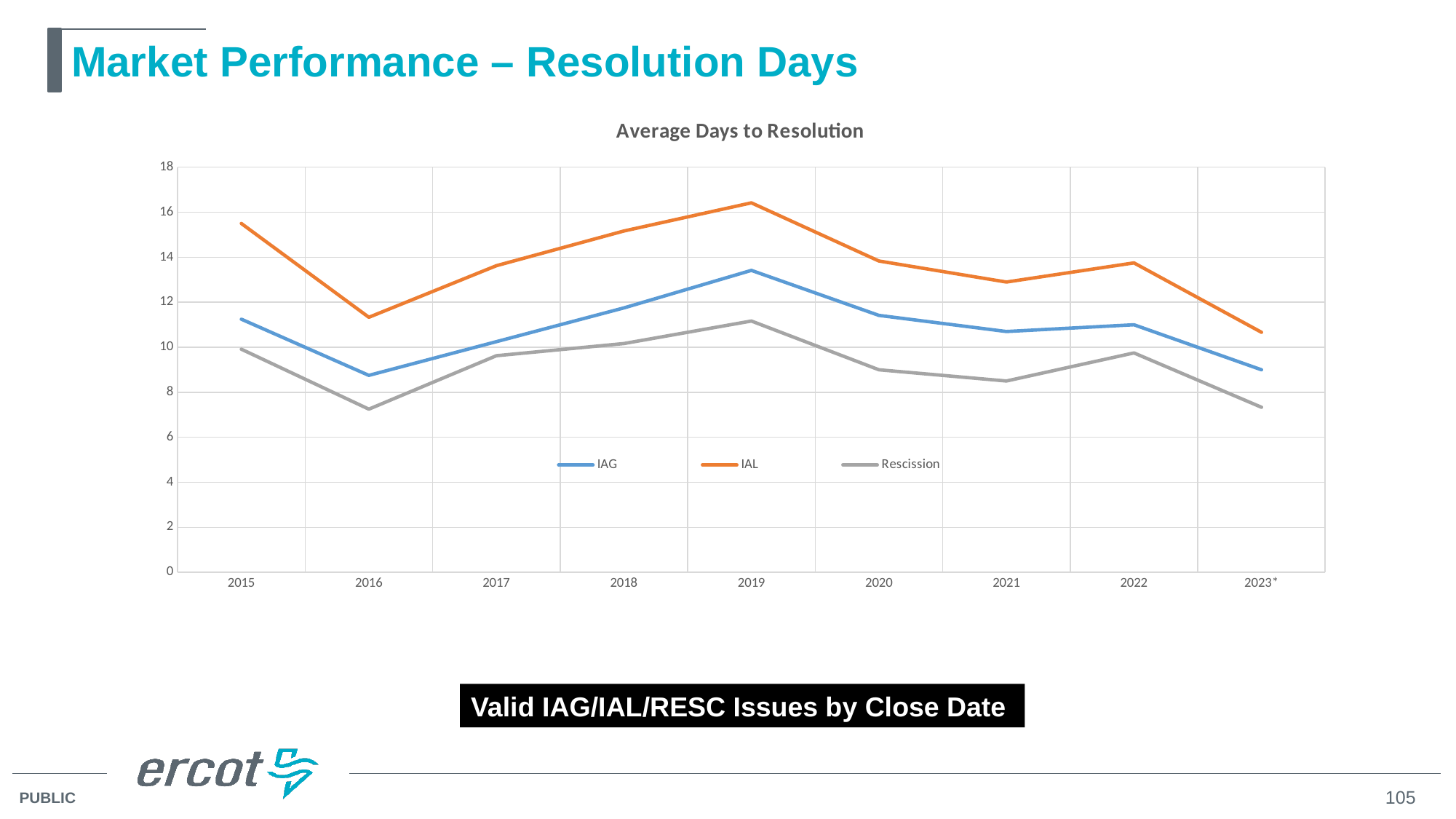
In 2019, which series has the larger value, IAL or IAG? IAL In which year does the IAL series reach its highest value? 2019 What is the title of the chart? Average Days to Resolution Is the value for IAL in 2015 greater or less than 14? greater Is the value for IAG in 2019 greater or less than 12? greater How many years are plotted along the x axis? 9 How many series does the legend list? 3 In which year does the IAG series reach its highest value? 2019 Does the IAL series rise or fall from 2016 to 2019? Rise What kind of chart is shown on the slide? Line chart For the Rescission series, which year has the larger value, 2015 or 2016? 2015 Is the value for Rescission in 2016 greater or less than 8? less